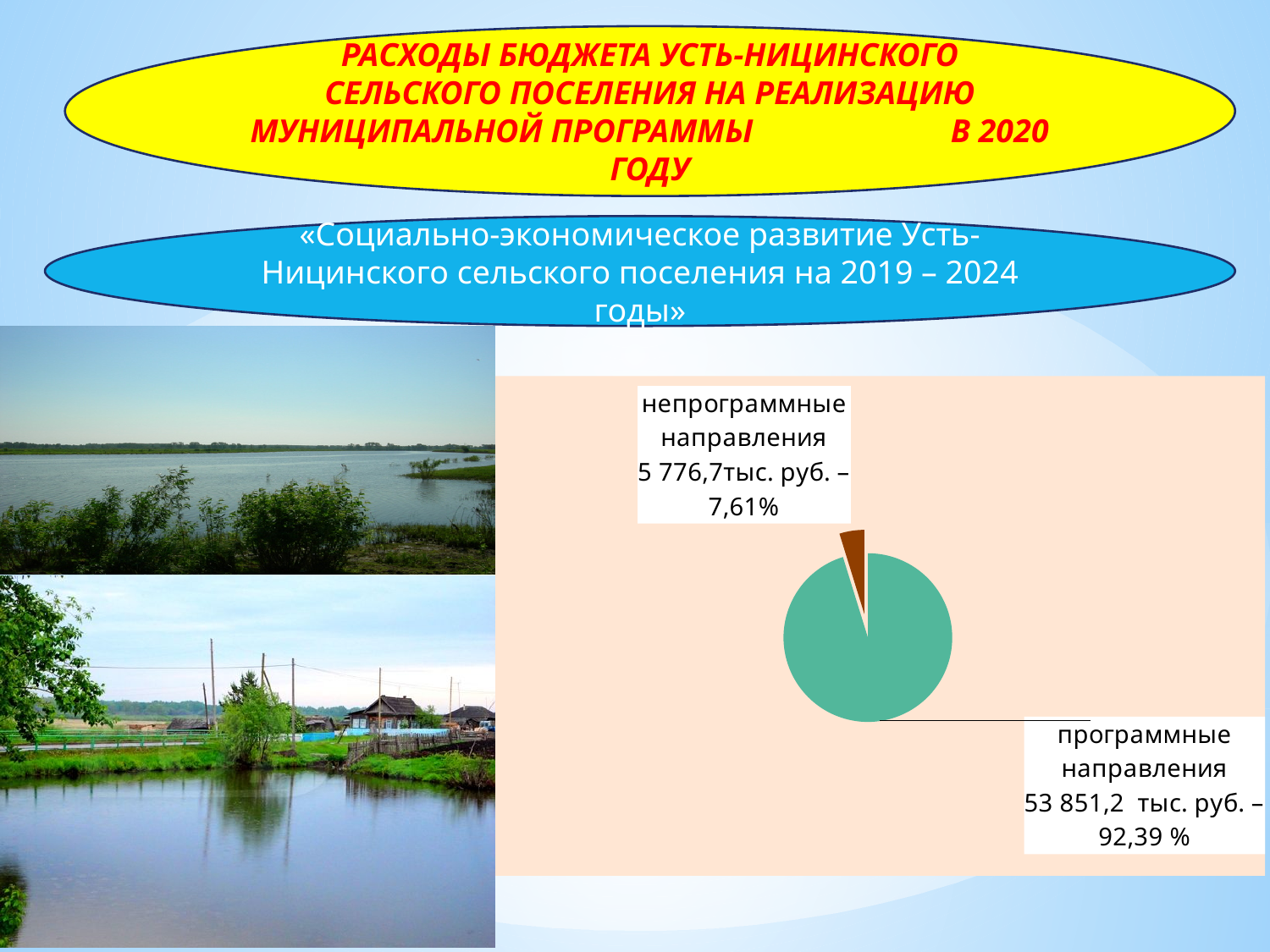
What colour is the slice for непрограммные направления? brown Which slice of the pie chart is the largest? программные направления What kind of chart is shown on the slide? pie chart What share of the pie do непрограммные направления make up? 7,61% Which slice of the pie chart is the smallest? непрограммные направления What is the value for программные направления? 53 851,2 тыс. руб. What is the total of the two slices in тыс. руб.? 59 627,9 тыс. руб. How many slices does the pie chart have? 2 Which is larger: программные направления or непрограммные направления? программные направления What is the value for непрограммные направления? 5 776,7 тыс. руб. What share of the pie do программные направления make up? 92,39 % What is the difference in тыс. руб. between программные направления and непрограммные направления? 48 074,5 тыс. руб.